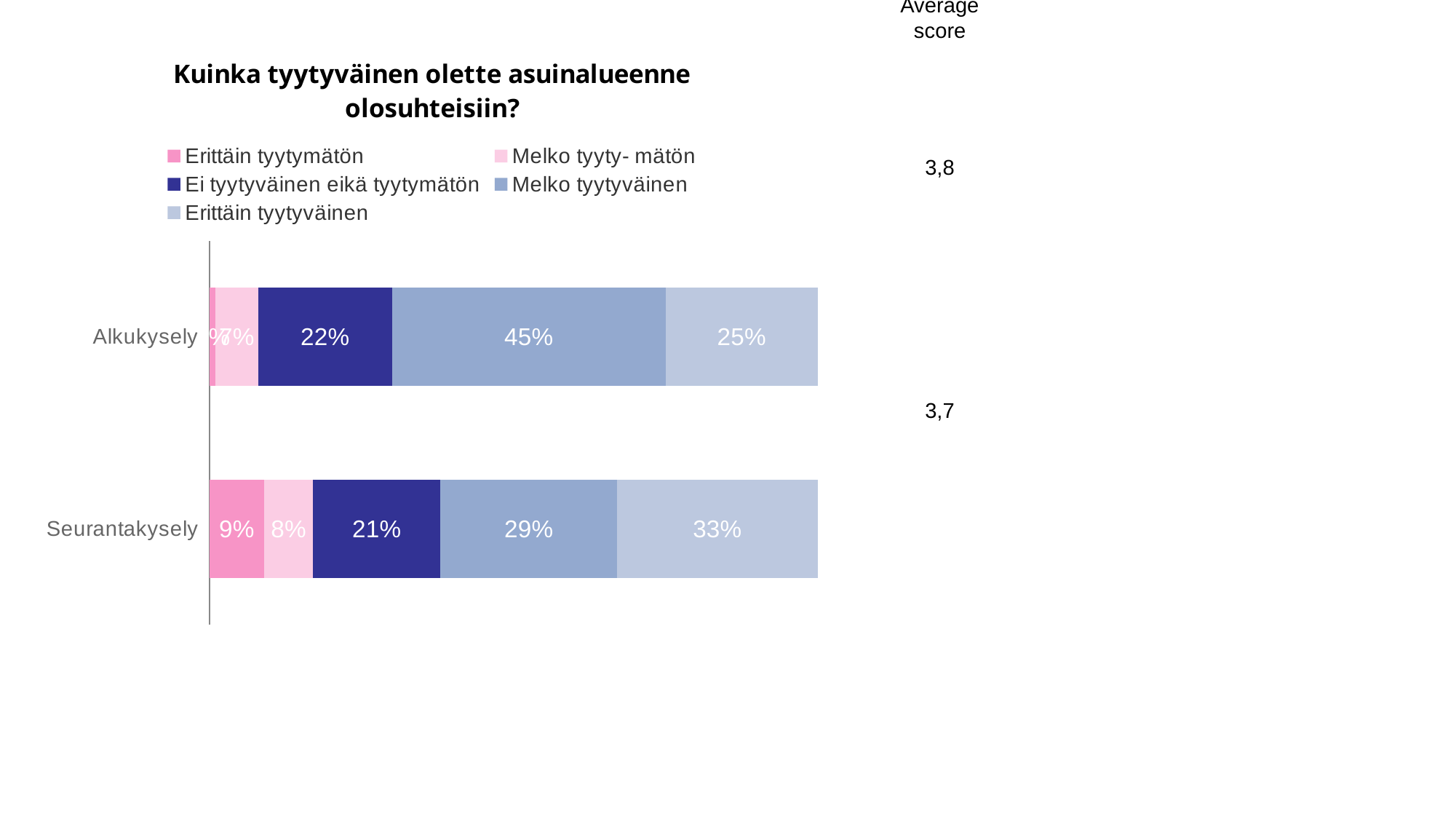
What percentage of Alkukysely respondents answered "Melko tyytyväinen"? 45% What is the "Erittäin tyytymätön" share for Seurantakysely? 9% How many response categories does the legend list? 5 Which response category has the largest share in the Alkukysely bar? Melko tyytyväinen By how many percentage points is the "Erittäin tyytyväinen" share higher in Seurantakysely than in Alkukysely? 8 percentage points What type of chart is shown on the slide? Stacked bar chart How many survey rounds (bars) are shown in the chart? 2 Which response category has the largest share in the Seurantakysely bar? Erittäin tyytyväinen By how many percentage points does the "Melko tyytyväinen" share differ between Alkukysely and Seurantakysely? 16 percentage points What percentage of Seurantakysely respondents answered "Erittäin tyytyväinen"? 33% Which survey has the larger "Erittäin tyytyväinen" share, Alkukysely or Seurantakysely? Seurantakysely What is the "Ei tyytyväinen eikä tyytymätön" share for Alkukysely? 22%